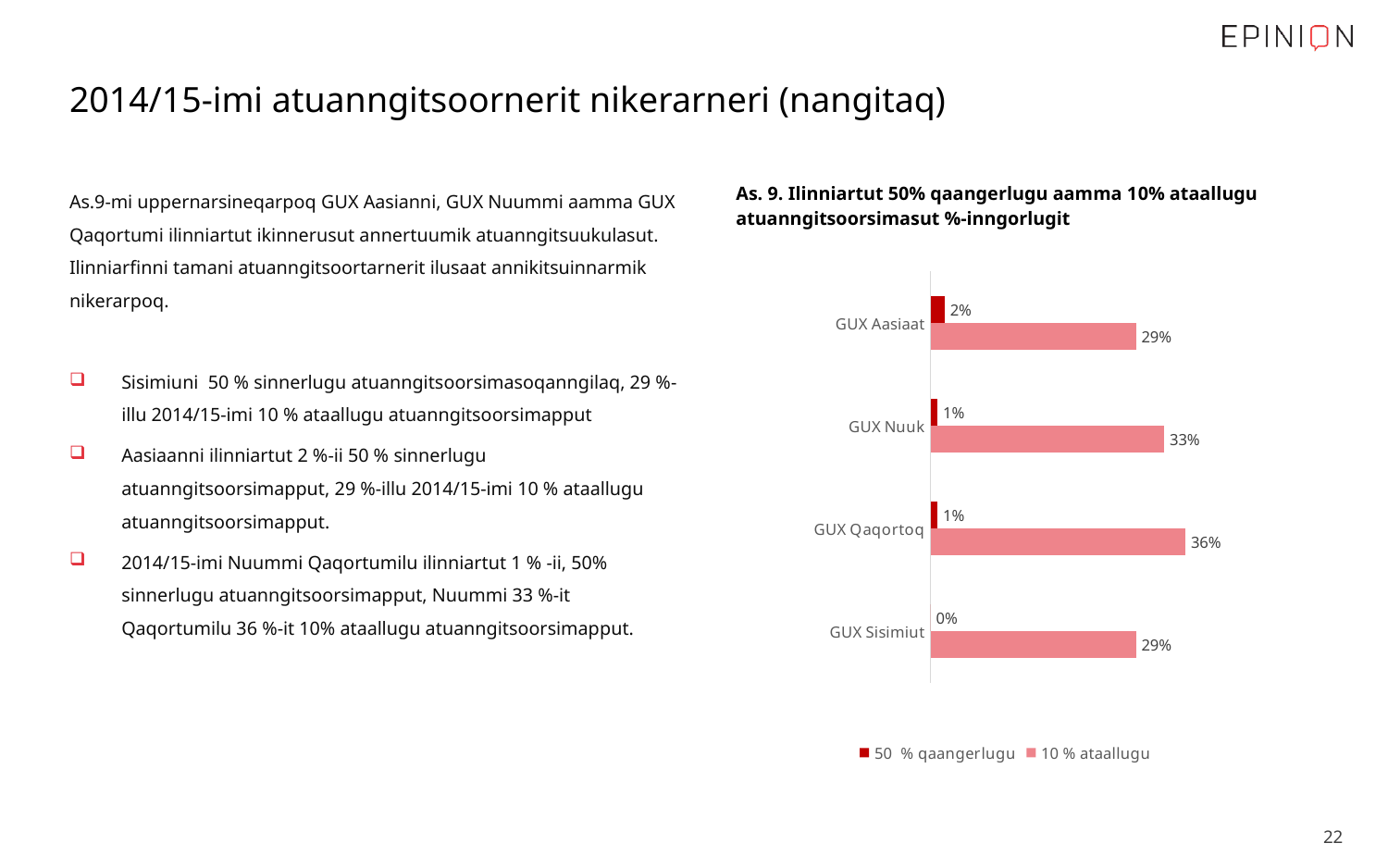
Which school has the highest value in the '10 % ataallugu' series? GUX Qaqortoq What kind of chart is shown on the slide? Bar chart Which school has the lowest value in the '50 % qaangerlugu' series? GUX Sisimiut What is the value for GUX Nuuk in the '10 % ataallugu' series? 33% What is the difference between the '10 % ataallugu' values for GUX Qaqortoq and GUX Aasiaat? 7% Which is larger: the '10 % ataallugu' value for GUX Nuuk or for GUX Sisimiut? GUX Nuuk What is the value for GUX Sisimiut in the '50 % qaangerlugu' series? 0% How many series does the legend list? 2 What is the value for GUX Aasiaat in the '50 % qaangerlugu' series? 2% How many schools are shown on the chart? 4 What is the value for GUX Qaqortoq in the '50 % qaangerlugu' series? 1% Which series is shown in dark red in the legend? 50 % qaangerlugu